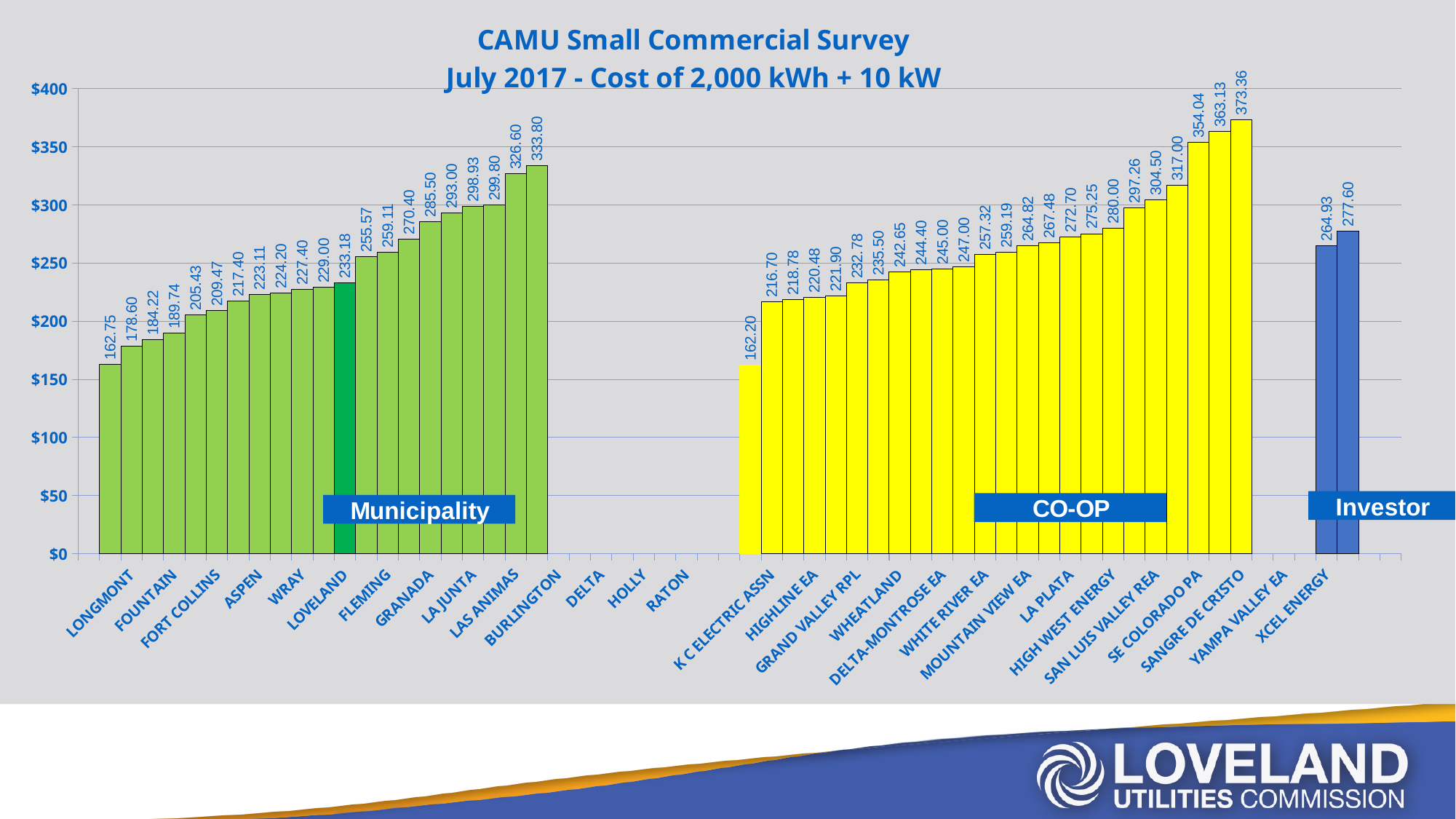
What is the value of the lowest bar in the Municipality group? 162.75 What is the difference between the highest bar on the chart (373.36) and the lowest bar (162.20)? 211.16 What is the value of the lowest bar on the chart? 162.20 What is the value of the highest bar on the chart? 373.36 What kind of chart is shown on the slide? bar chart What is the title of the chart? CAMU Small Commercial Survey July 2017 - Cost of 2,000 kWh + 10 kW Which is larger: the Loveland bar or the highest bar in the Investor group? the highest Investor bar What is the difference between the highest Municipality bar (333.80) and the Loveland bar (233.18)? 100.62 What is the value of the dark green bar labelled Loveland? 233.18 What is the value of the highest bar in the Municipality group? 333.80 Within each group, do the bar values rise or fall from left to right? rise Is the value for Loveland greater or less than $250? less